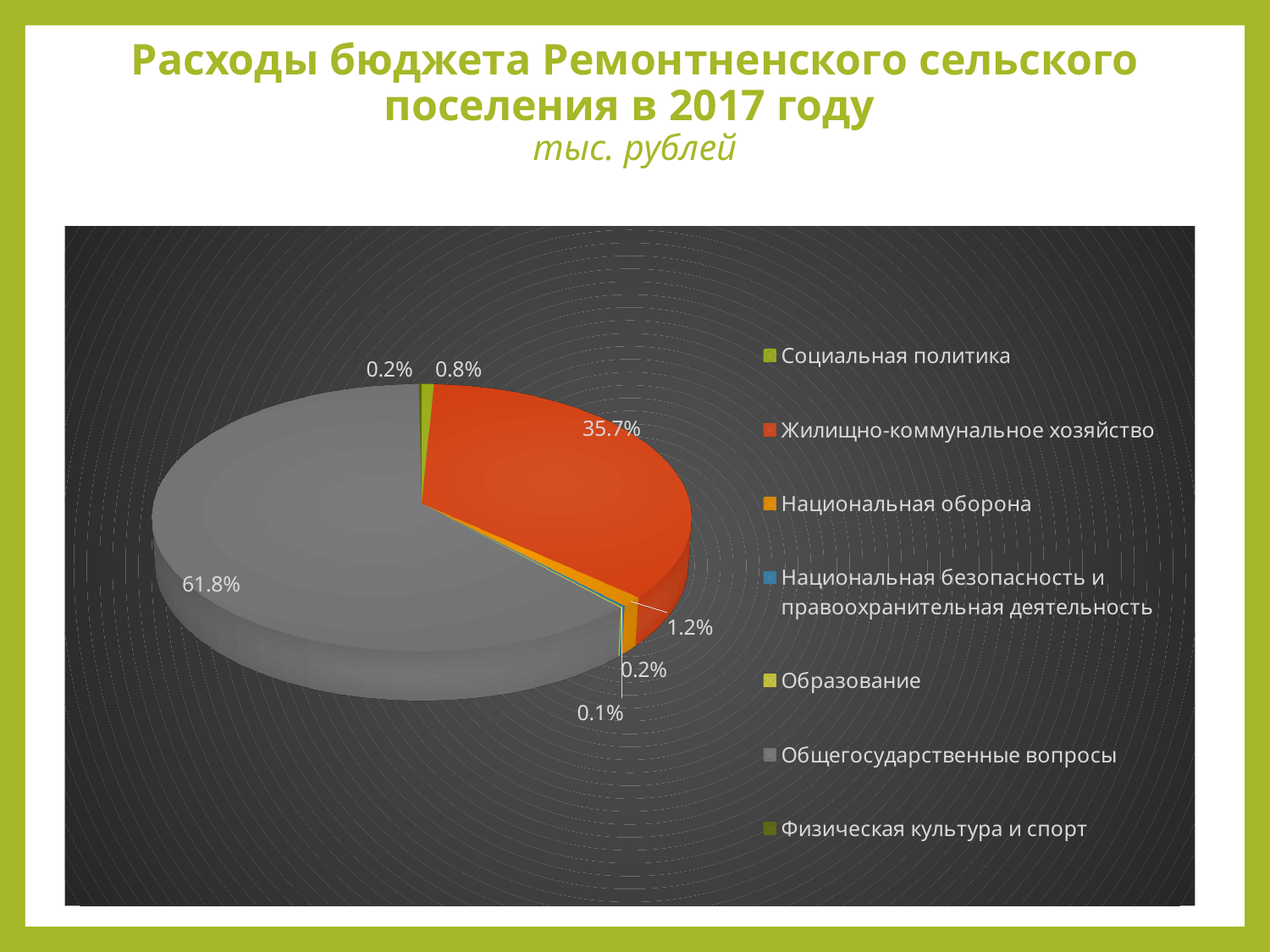
Which is larger, the share for Жилищно-коммунальное хозяйство or the share for Общегосударственные вопросы? Общегосударственные вопросы What unit is given in the subtitle under the chart title? тыс. рублей What kind of chart is shown on the slide? pie chart What share of the pie does Жилищно-коммунальное хозяйство have? 35.7% What share of the pie does Социальная политика have? 0.8% What is the smallest percentage label shown on the pie? 0.1% What share of the pie does Национальная оборона have? 1.2% How many categories does the legend list? 7 Which category has the largest share of the pie? Общегосударственные вопросы What is the difference between the shares for Общегосударственные вопросы and Жилищно-коммунальное хозяйство? 26.1% What is the title of the chart? Расходы бюджета Ремонтненского сельского поселения в 2017 году